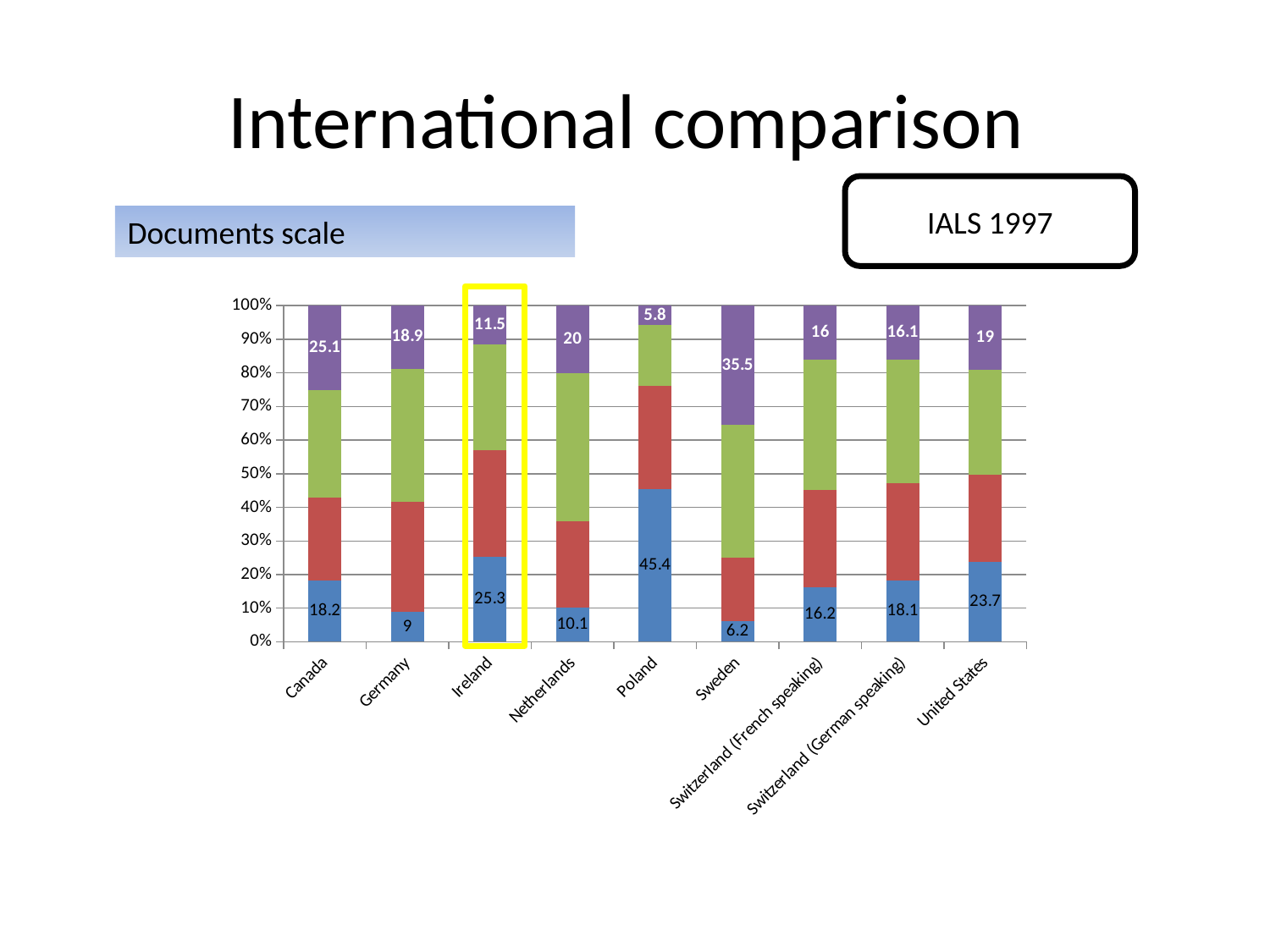
What is the value printed on the top (purple) segment of the bar for Sweden? 35.5 Which is larger: the top (purple) segment value for Canada or for Germany? Canada Which country has the highest value printed on its bottom (blue) segment? Poland How many countries are shown on the x axis of the chart? 9 What kind of chart is shown on the slide? Stacked bar chart What is the value printed on the bottom (blue) segment of the bar for Ireland? 25.3 What is the value printed on the bottom (blue) segment of the bar for Poland? 45.4 Which country has the lowest value printed on its bottom (blue) segment? Sweden Which country has the lowest value printed on its top (purple) segment? Poland What is the value printed on the top (purple) segment of the bar for Netherlands? 20 Which country's bar is outlined with a yellow rectangle? Ireland What is the difference between the bottom (blue) segment values for United States and Germany? 14.7